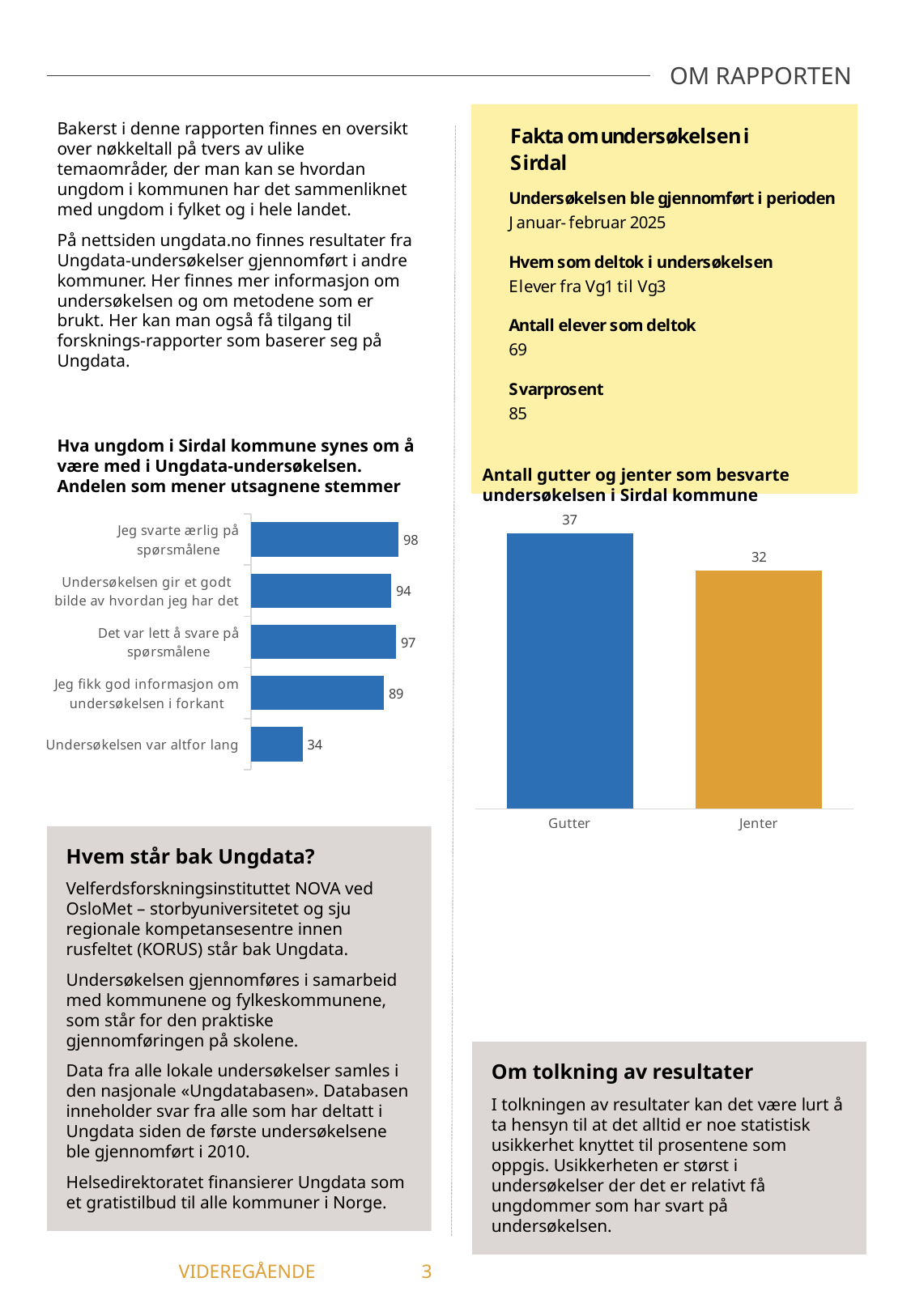
In the left chart on what youth in Sirdal think about participating in the Ungdata survey, how many statements are shown? 5 In the left chart on what youth in Sirdal think about participating in the Ungdata survey, what is the value for "Jeg fikk god informasjon om undersøkelsen i forkant"? 89 In the left chart on what youth in Sirdal think about participating in the Ungdata survey, what is the value for "Undersøkelsen var altfor lang"? 34 In the left chart on what youth in Sirdal think about participating in the Ungdata survey, which statement has the highest value? Jeg svarte ærlig på spørsmålene In the chart "Antall gutter og jenter som besvarte undersøkelsen i Sirdal kommune", which group is larger, Gutter or Jenter? Gutter In the chart "Antall gutter og jenter som besvarte undersøkelsen i Sirdal kommune", what is the difference between Gutter and Jenter? 5 In the left chart on what youth in Sirdal think about participating in the Ungdata survey, what is the value for "Jeg svarte ærlig på spørsmålene"? 98 In the left chart on what youth in Sirdal think about participating in the Ungdata survey, what is the difference between "Det var lett å svare på spørsmålene" and "Jeg fikk god informasjon om undersøkelsen i forkant"? 8 In the chart "Antall gutter og jenter som besvarte undersøkelsen i Sirdal kommune", how many boys (Gutter) answered the survey? 37 In the left chart on what youth in Sirdal think about participating in the Ungdata survey, which statement has the lowest value? Undersøkelsen var altfor lang In the chart "Antall gutter og jenter som besvarte undersøkelsen i Sirdal kommune", how many girls (Jenter) answered the survey? 32 What kind of chart is the left chart on what youth in Sirdal think about participating in the Ungdata survey? Bar chart